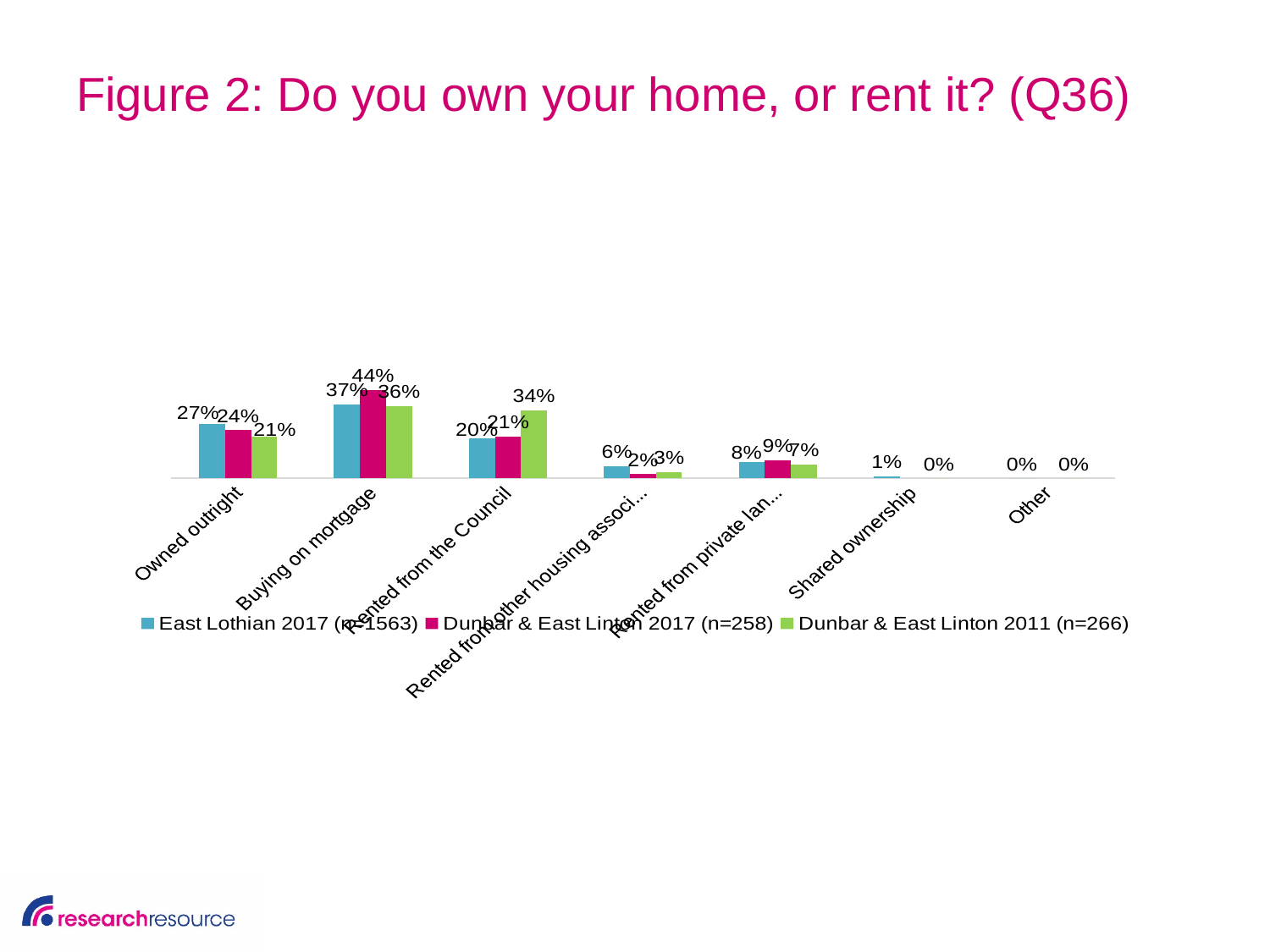
What percentage of East Lothian 2017 respondents own their home outright? 27% How many categories are shown on the x axis? 7 What kind of chart is shown on the slide? Bar chart For Owned outright, which is larger: East Lothian 2017 or Dunbar & East Linton 2017? East Lothian 2017 Which category has the highest value for the East Lothian 2017 series? Buying on mortgage What is the title of the chart? Figure 2: Do you own your home, or rent it? (Q36) What is the East Lothian 2017 value for Shared ownership? 1% What is the value for Rented from the Council in the Dunbar & East Linton 2011 series? 34% How many series does the legend list? 3 What is the Dunbar & East Linton 2017 value for Rented from other housing association? 2% What is the difference between the Dunbar & East Linton 2011 and Dunbar & East Linton 2017 values for Rented from the Council? 13 percentage points What percentage of Dunbar & East Linton 2017 respondents are buying on mortgage? 44%